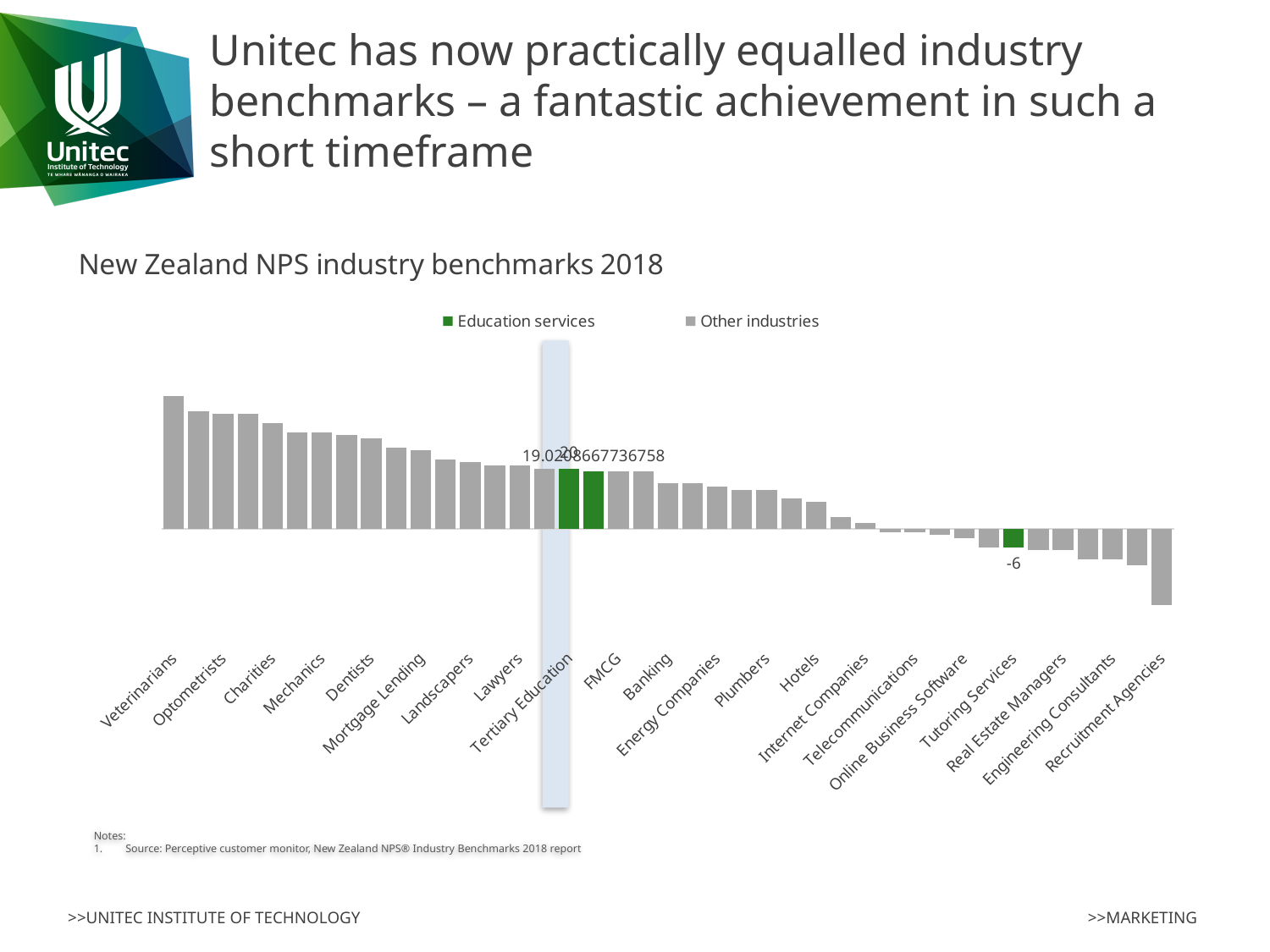
Which industry has the lowest NPS benchmark in the chart? Recruitment Agencies Which has a higher value, Dentists or Hotels? Dentists Which has a higher value, Veterinarians or Recruitment Agencies? Veterinarians What is the title of the chart? New Zealand NPS industry benchmarks 2018 What kind of chart is shown on the slide? Bar chart Which industry has the highest NPS benchmark in the chart? Veterinarians Do the values generally rise or fall moving from left to right along the x axis? Fall How many series does the chart legend list? 2 What is the value shown for Tutoring Services? -6 Which has a higher value, Tertiary Education or Tutoring Services? Tertiary Education Which series is shown in green in the chart? Education services